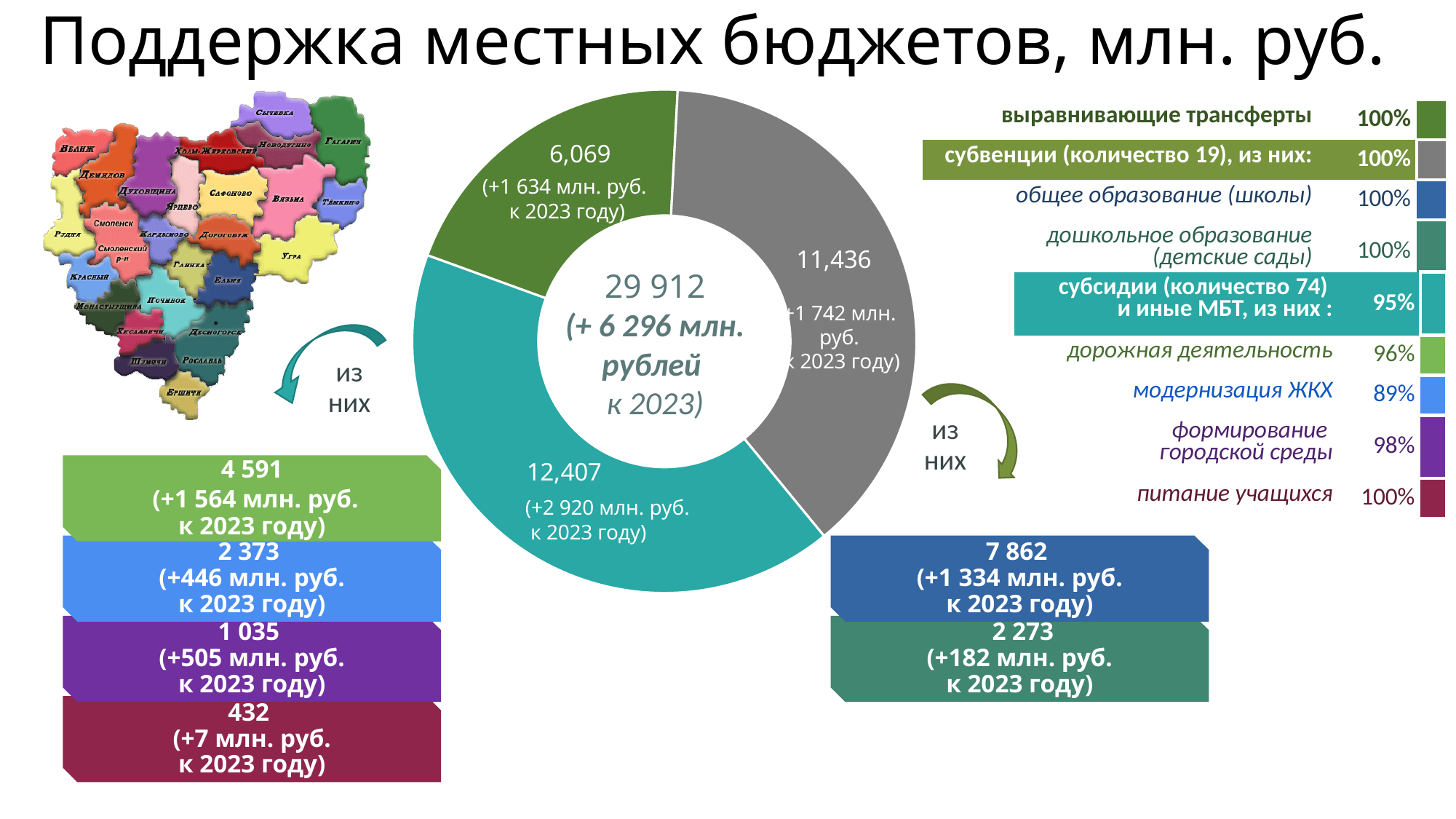
What total value is shown in the centre of the donut chart? 29 912 What value is shown on the gray segment of the donut chart? 11,436 What share of the donut chart total (29 912) does the teal segment (12,407) represent, to one decimal place? 41.5% How many segments does the donut chart have? 3 What value is shown on the green segment of the donut chart? 6,069 Which segment of the donut chart is larger: the gray one or the green one? the gray one (11,436) What is the value of the smallest segment of the donut chart? 6,069 What is the difference between the gray segment (11,436) and the green segment (6,069) of the donut chart? 5,367 What increase to 2023 is printed next to the teal segment (12,407) of the donut chart? +2 920 млн. руб. What is the value of the largest segment of the donut chart? 12,407 What kind of chart is shown in the centre of the slide? pie chart (donut) What is the difference between the teal segment (12,407) and the gray segment (11,436) of the donut chart? 971